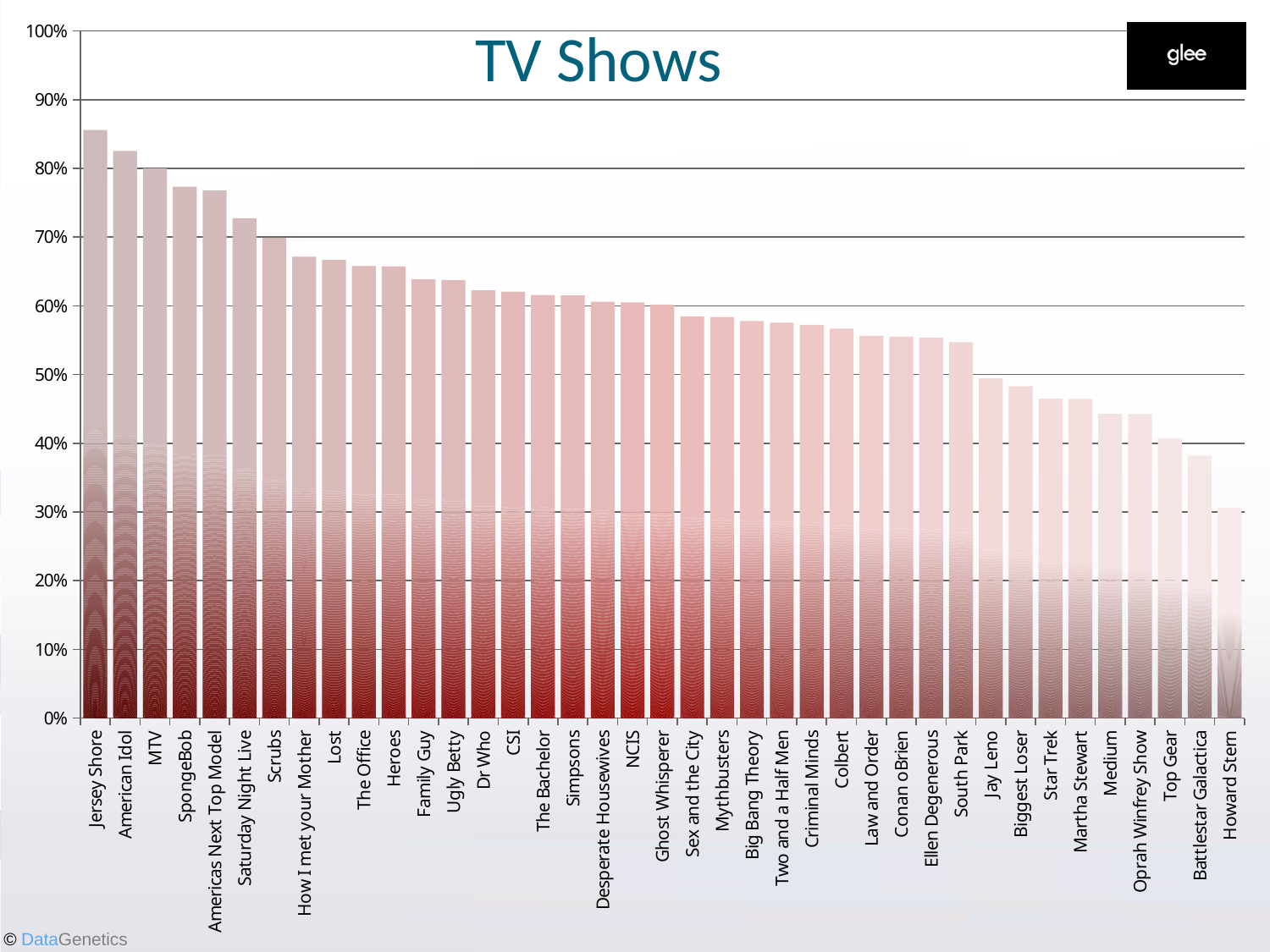
Which has the larger value, Battlestar Galactica or American Idol? American Idol Is the value for South Park greater or less than 60%? less How many TV shows are plotted in the chart? 39 What is the title of the chart? TV Shows Which TV show has the highest value in the chart? Jersey Shore Is the value for Saturday Night Live greater or less than 70%? greater Which TV show has the lowest value in the chart? Howard Stern Is the value for Howard Stern greater or less than 40%? less Which has the larger value, Scrubs or South Park? Scrubs What kind of chart is shown on the slide? bar chart Do the values rise or fall moving from left to right along the x axis? fall